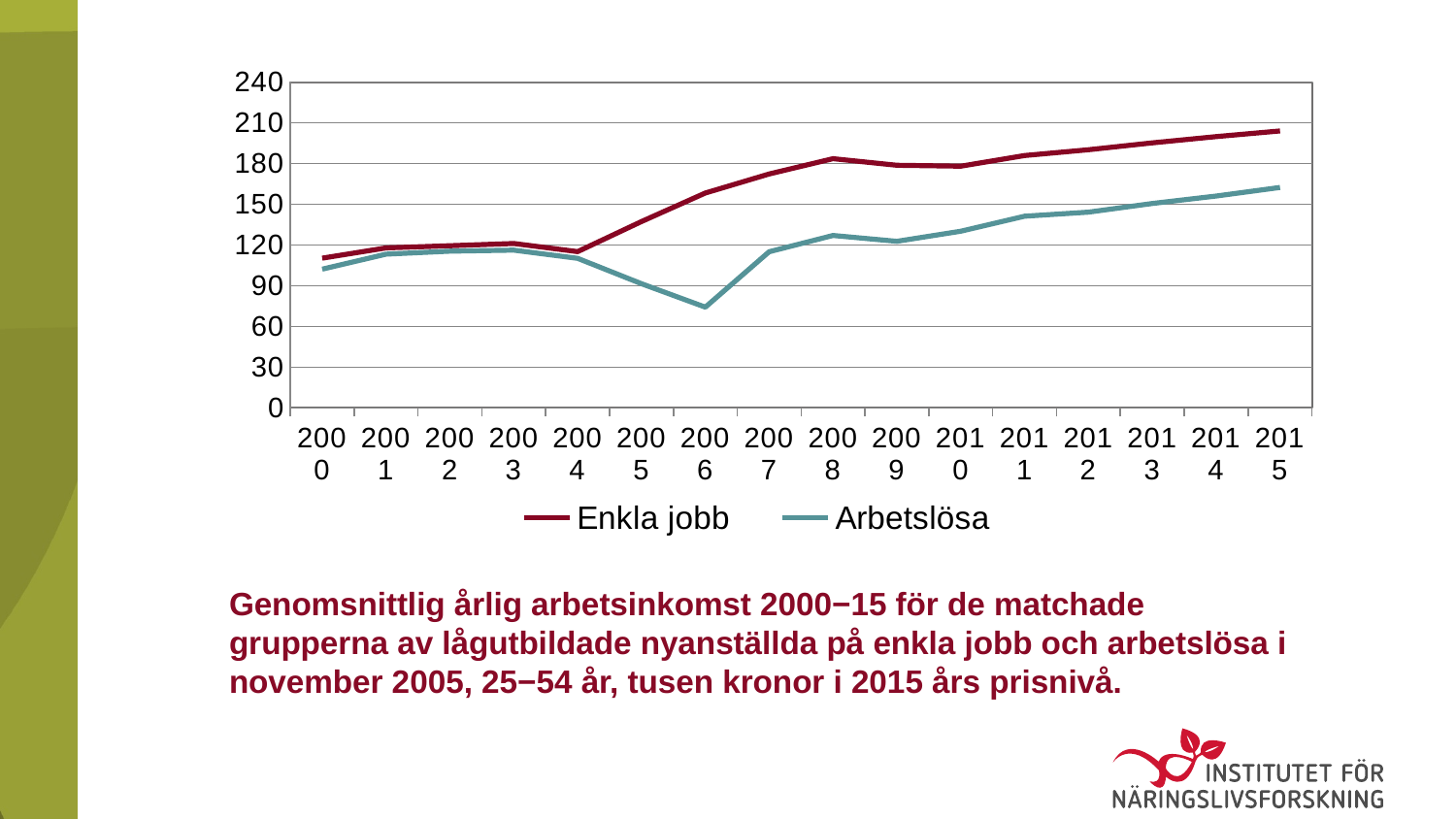
How many years are plotted along the x axis? 16 What kind of chart is shown on the slide? Line chart Does the Arbetslösa series rise or fall from 2006 to 2015? Rise How many series does the legend list? 2 Is the value for Arbetslösa in 2006 greater or less than 90? less Which series is shown in dark red in the legend? Enkla jobb In which year does the Arbetslösa series reach its lowest value? 2006 Is the value for Arbetslösa in 2015 greater or less than 150? greater Is the value for Enkla jobb in 2000 greater or less than 120? less In which year does the Enkla jobb series reach its highest value? 2015 In 2010, which series has the higher value, Enkla jobb or Arbetslösa? Enkla jobb